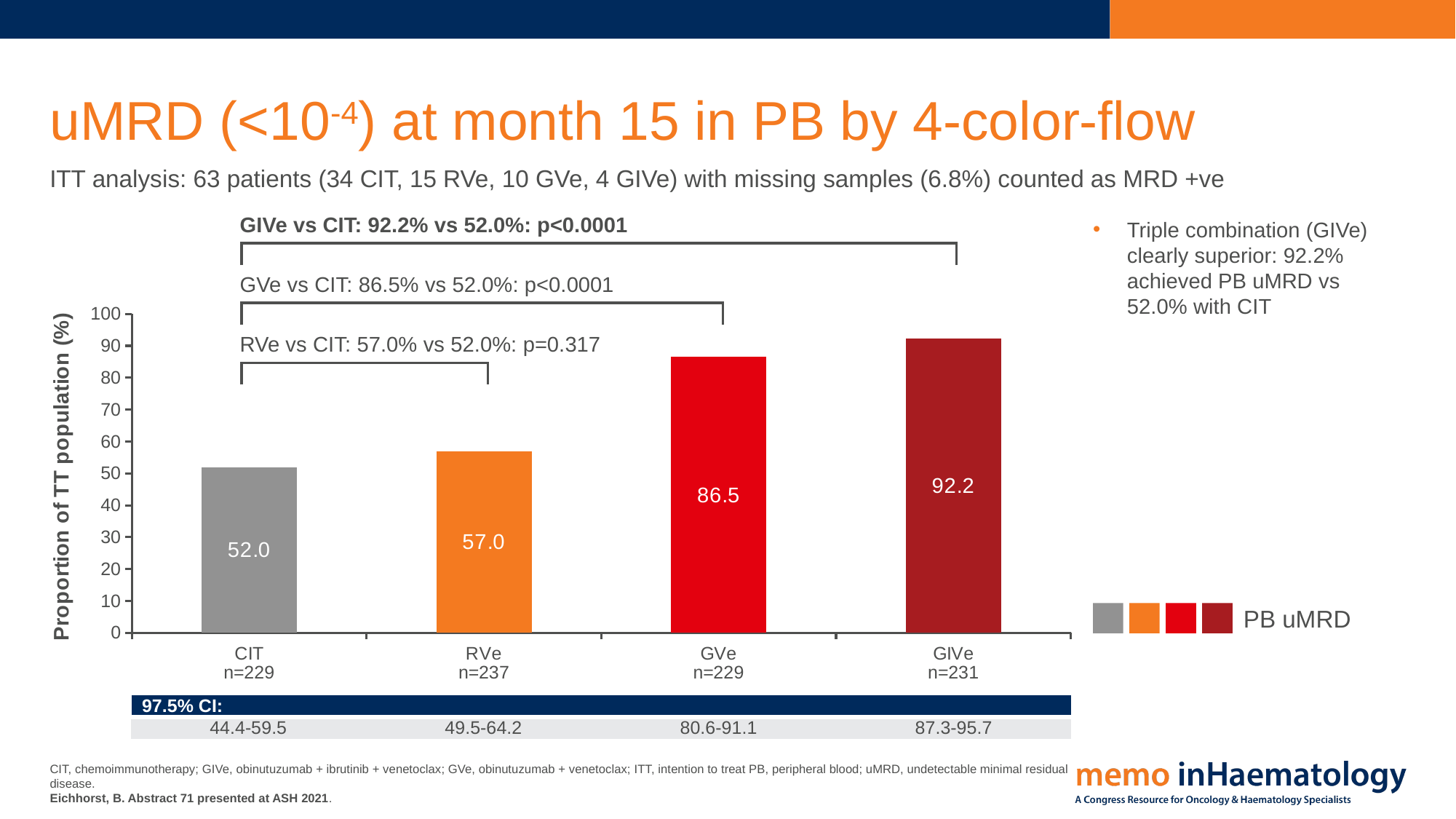
Which arm has the lowest PB uMRD value? CIT What is the PB uMRD value for the GVe arm? 86.5 What is the PB uMRD value for the CIT arm? 52.0 Which arm has the highest PB uMRD value? GIVe What kind of chart is shown on the slide? bar chart What is the PB uMRD value for the GIVe arm? 92.2 What is the difference between the PB uMRD values for GIVe and CIT? 40.2 What is the difference between the PB uMRD values for GVe and RVe? 29.5 How many treatment arms are shown on the x axis? 4 Is the value for RVe greater or less than 60? less What is the label on the y axis of the chart? Proportion of ITT population (%) Which arm has a larger PB uMRD value, RVe or GVe? GVe